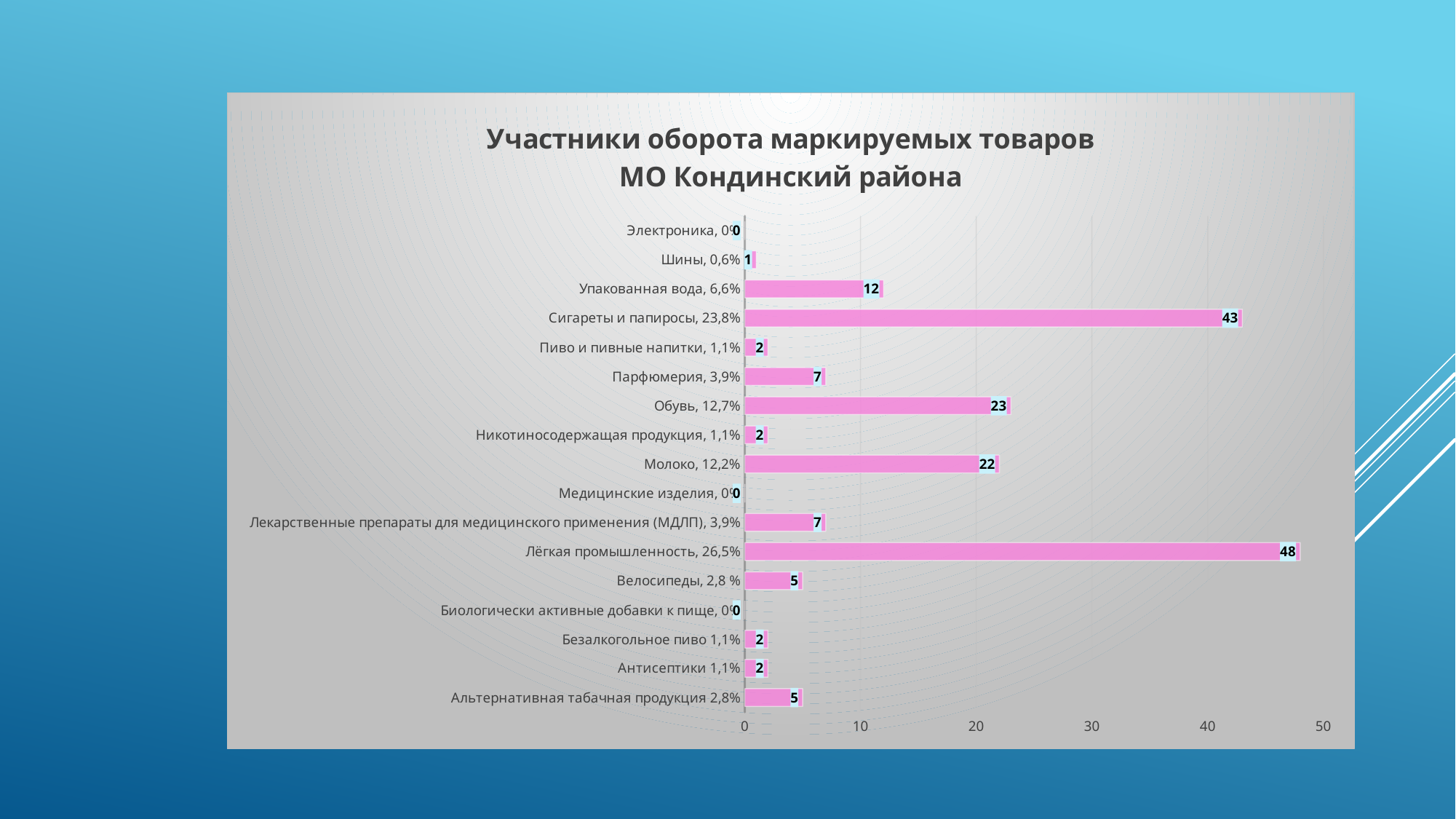
What is the value for Лёгкая промышленность? 48 Is the value for Сигареты и папиросы greater or less than 40? greater What is the value for Сигареты и папиросы? 43 What is the difference between the values for Лёгкая промышленность and Сигареты и папиросы? 5 What is the value for Молоко? 22 Which is larger, the value for Обувь or the value for Молоко? Обувь What is the difference between the values for Обувь and Парфюмерия? 16 What is the title of the chart? Участники оборота маркируемых товаров МО Кондинский района Which category has the highest value? Лёгкая промышленность What type of chart is shown on the slide? bar chart How many categories are shown in the chart? 17 What is the value for Упакованная вода? 12